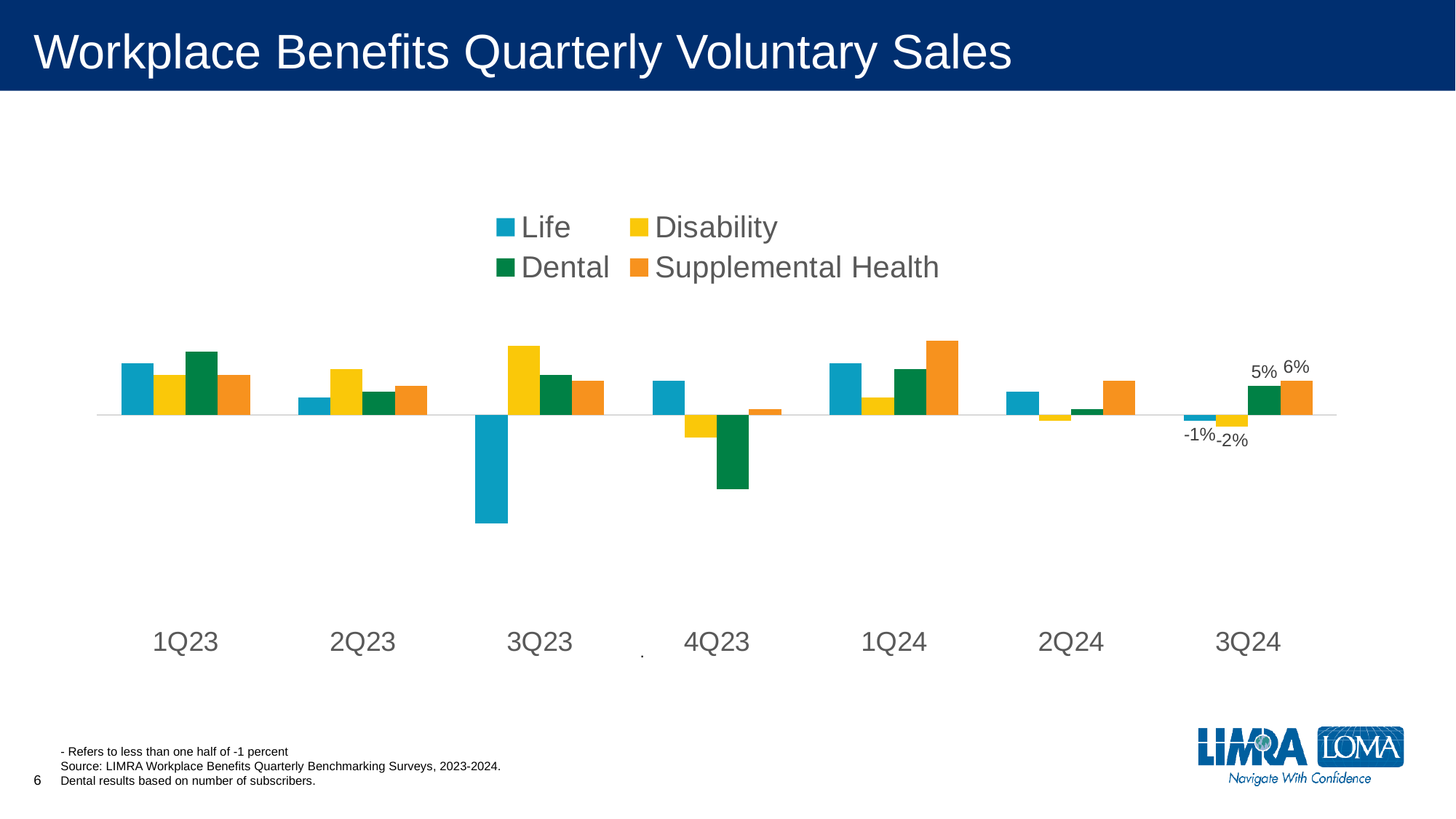
What is the value for Disability in 3Q24? -2% What is the value for Dental in 3Q24? 5% In which quarter is the Life value lowest? 3Q23 What is the value for Supplemental Health in 3Q24? 6% Which series has the lowest value in 3Q24? Disability What kind of chart is shown on the slide? bar chart What is the value for Life in 3Q24? -1% What is the difference between the Dental and Disability values in 3Q24? 7 percentage points How many quarters are shown on the x axis? 7 Which series has the highest value in 3Q24? Supplemental Health In 3Q23, which is larger: the Life value or the Disability value? Disability How many series does the legend list? 4